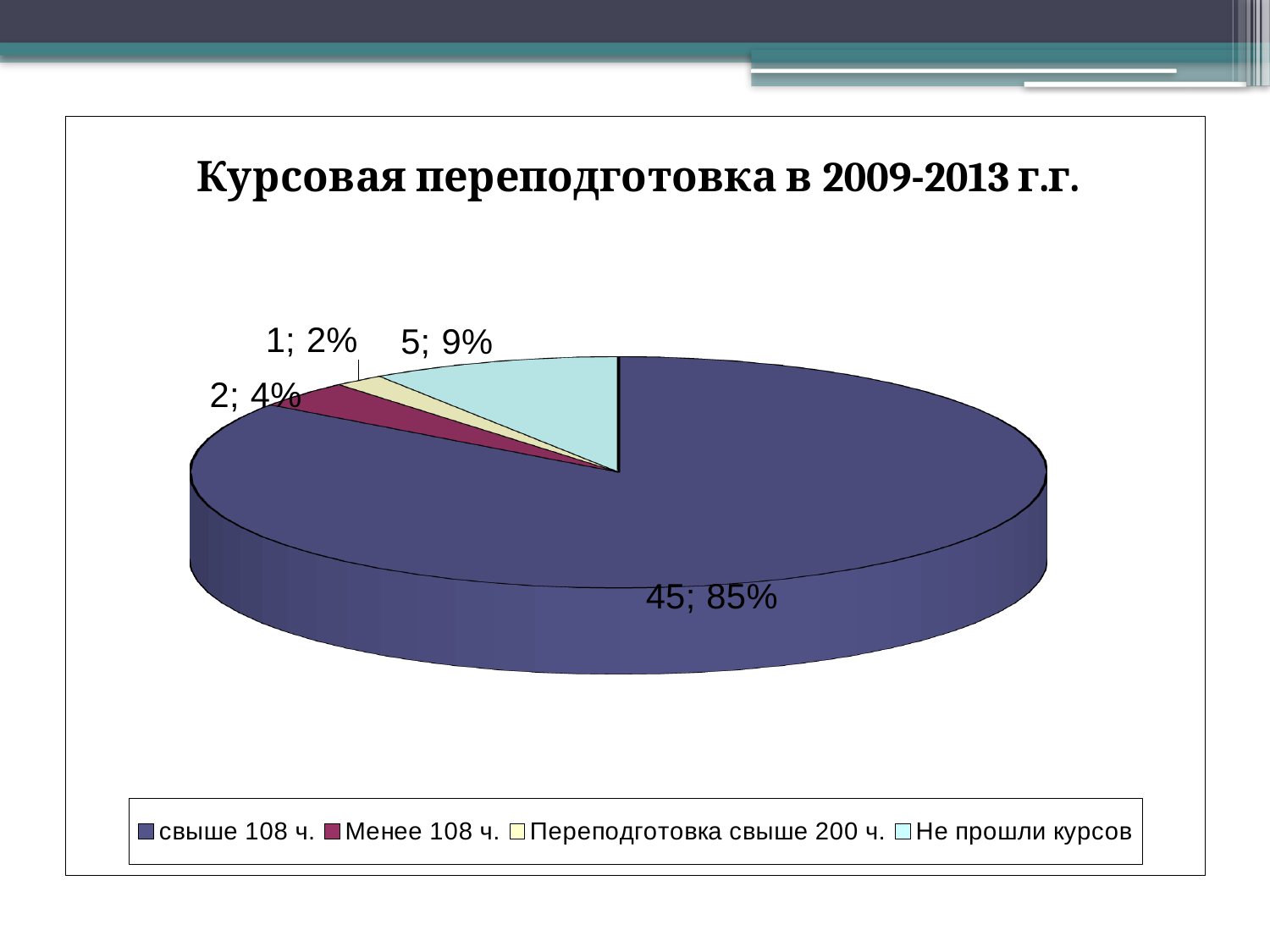
Which category has the largest slice of the pie? свыше 108 ч. How many slices does the pie chart have? 4 What percentage share does the slice "Менее 108 ч." have? 4% What is the title of the chart? Курсовая переподготовка в 2009-2013 г.г. What percentage share does the slice "Не прошли курсов" have? 9% Which category has the smallest slice of the pie? Переподготовка свыше 200 ч. Which is larger: the value for "Не прошли курсов" or the value for "Менее 108 ч."? Не прошли курсов What value is shown for the slice "Переподготовка свыше 200 ч."? 1 What type of chart is shown on the slide? pie chart What value is shown for the slice "свыше 108 ч."? 45 What is the difference between the value for "свыше 108 ч." and the value for "Не прошли курсов"? 40 What percentage share does the slice "свыше 108 ч." have? 85%